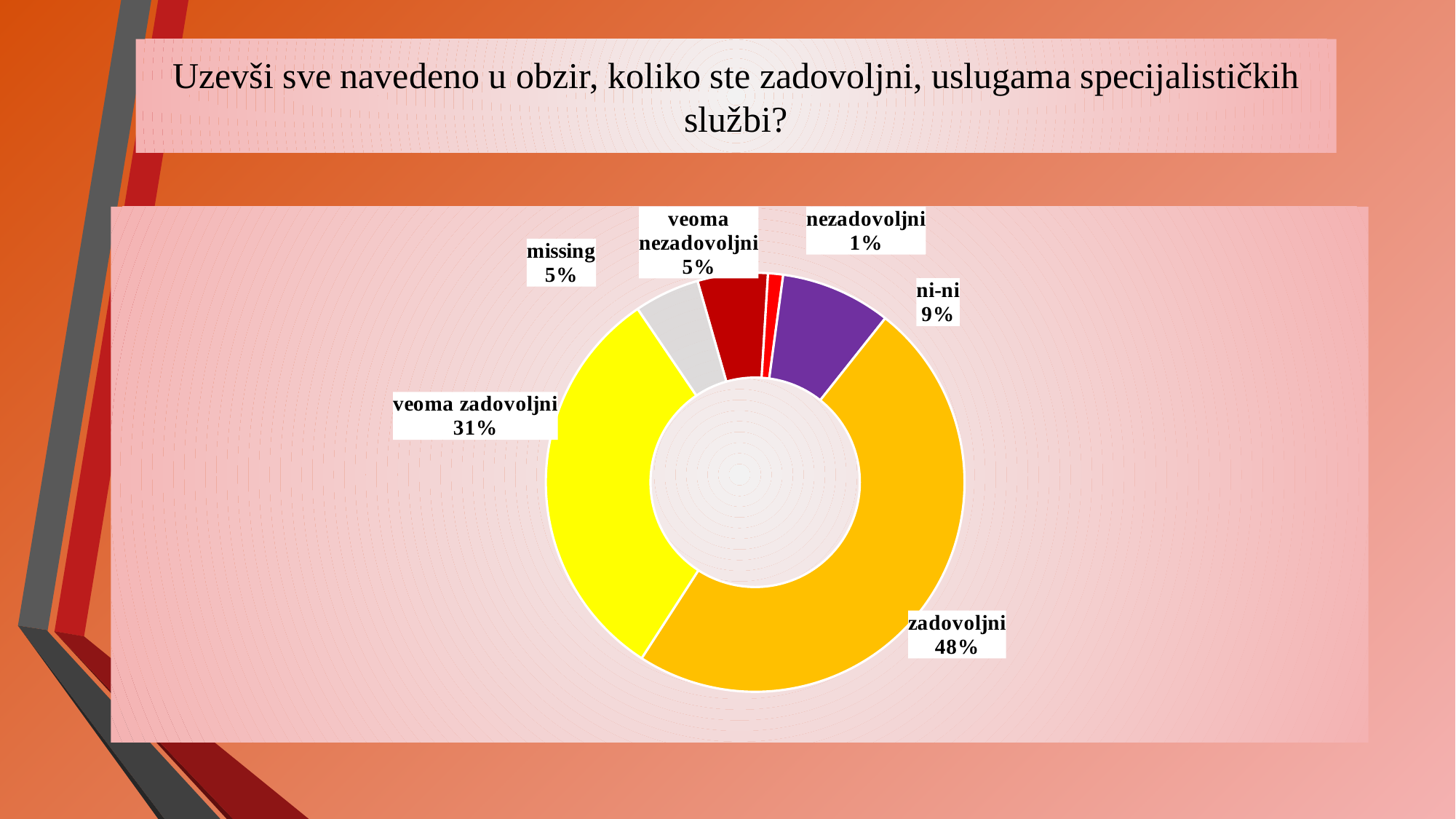
What share of the doughnut chart is labelled "zadovoljni"? 48% Which category has the smallest share of the chart? nezadovoljni What percentage is shown for "nezadovoljni"? 1% What percentage is shown for "veoma zadovoljni"? 31% Which is larger, the share for "ni-ni" or the share for "veoma nezadovoljni"? ni-ni Which category has the largest share of the chart? zadovoljni What percentage is shown for "missing"? 5% What colour is the "zadovoljni" segment of the chart? orange What type of chart is shown on the slide? doughnut chart How many categories are shown in the chart? 6 What percentage is shown for "ni-ni"? 9% What is the difference in percentage points between "zadovoljni" and "veoma zadovoljni"? 17